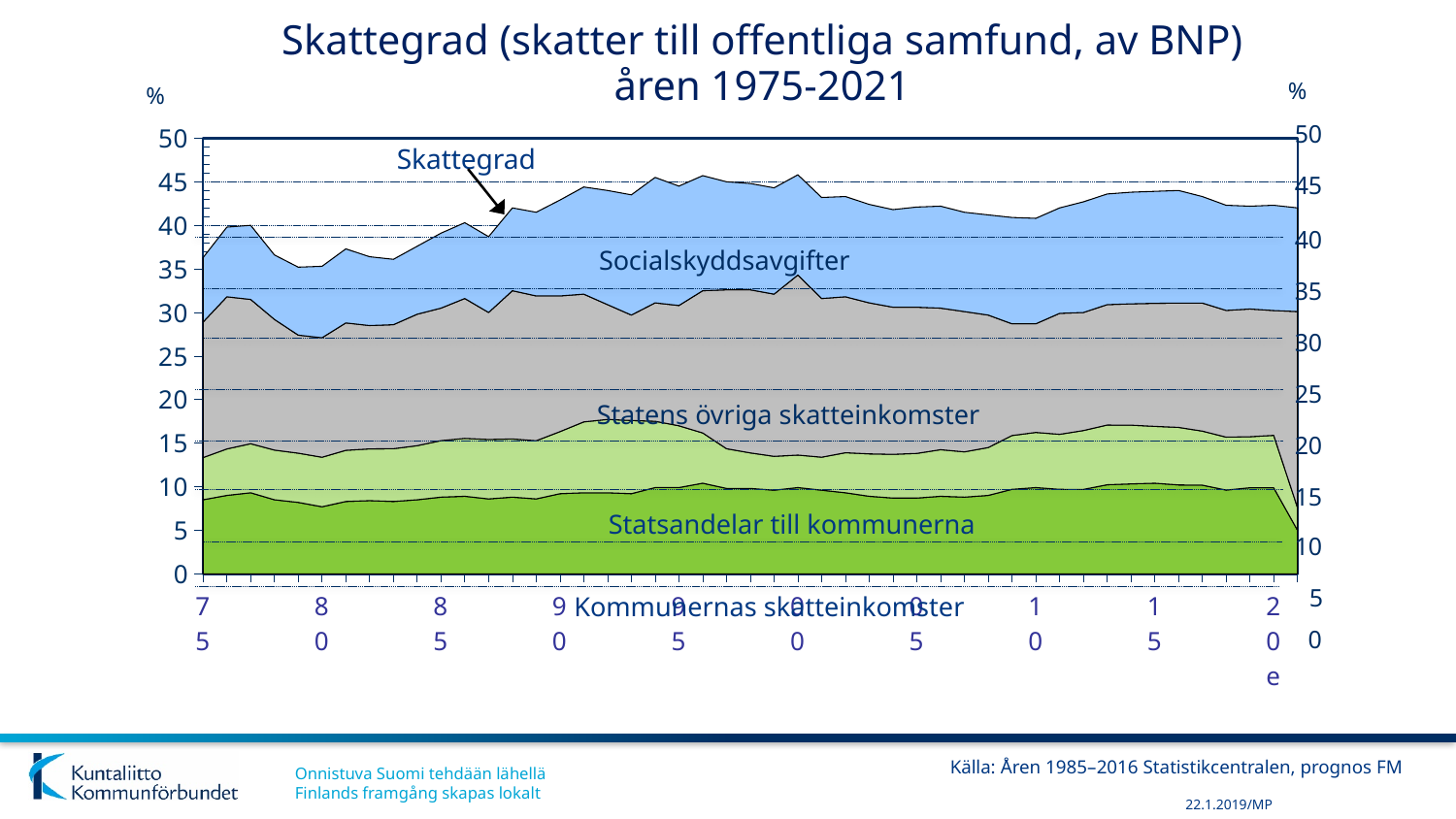
Is the Skattegrad value for 1990 greater or less than 40? greater Is the Skattegrad value for 2015 greater or less than 40? greater What is the title of the chart? Skattegrad (skatter till offentliga samfund, av BNP) åren 1975-2021 Is the Skattegrad value for 1985 greater or less than 35? greater Which series is labelled at the top of the stacked areas, just below the Skattegrad line? Socialskyddsavgifter What kind of chart is shown on the slide? Stacked area chart What is the highest value shown on the left y-axis? 50 Which is larger, the Skattegrad value for 1975 or for 2000? 2000 Does the Skattegrad line rise or fall between 1975 and 1990? rise